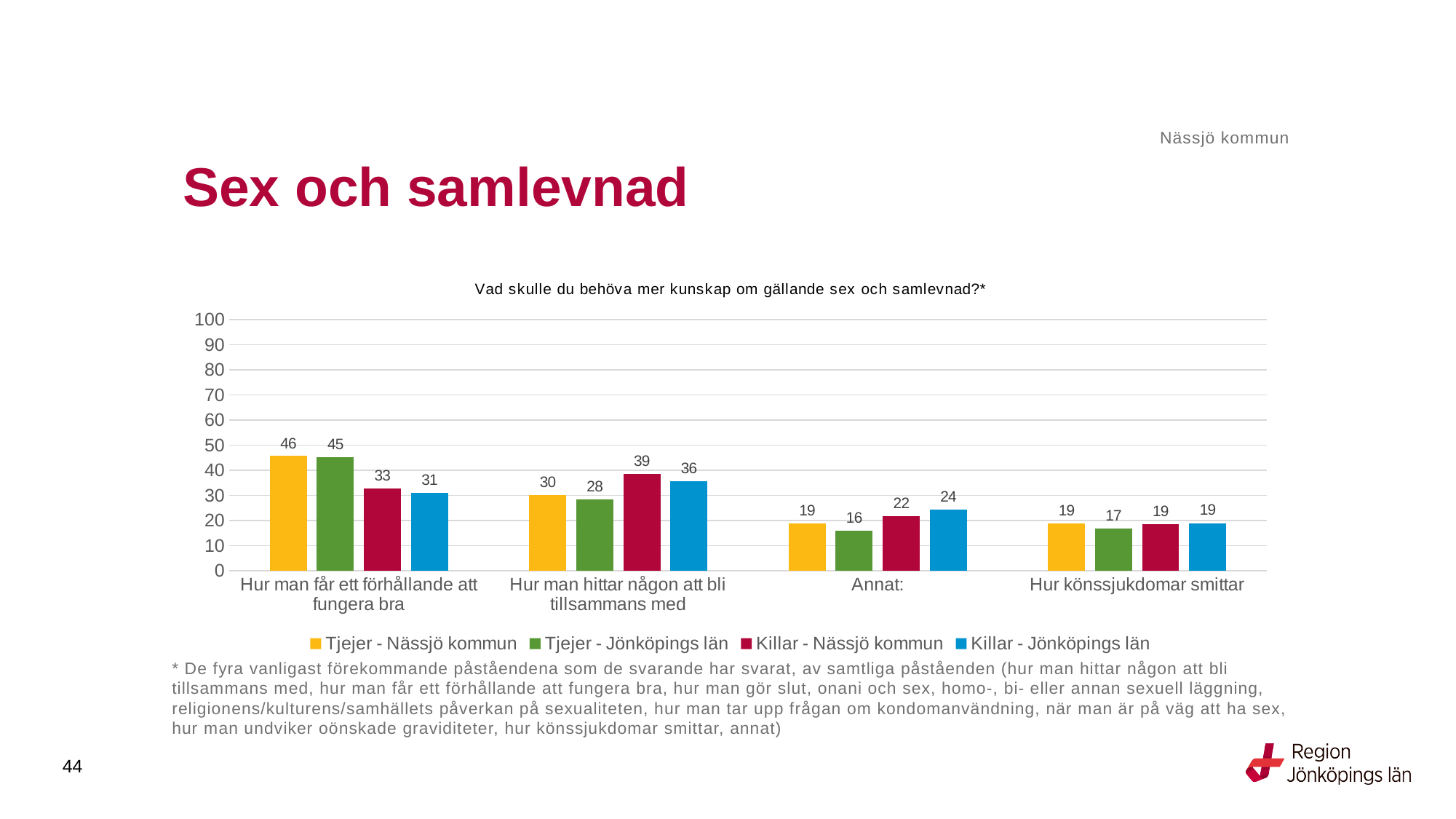
Which is larger for 'Hur man hittar någon att bli tillsammans med': Tjejer - Nässjö kommun or Killar - Nässjö kommun? Killar - Nässjö kommun How many categories are shown on the x axis? 4 What is the title of the chart? Vad skulle du behöva mer kunskap om gällande sex och samlevnad?* What is the value for Tjejer - Nässjö kommun for 'Hur man får ett förhållande att fungera bra'? 46 What is the difference between Tjejer - Nässjö kommun and Killar - Nässjö kommun for 'Hur man får ett förhållande att fungera bra'? 13 What is the value for Tjejer - Jönköpings län for 'Annat:'? 16 How many series does the legend list? 4 What kind of chart is shown on the slide? bar chart Which category has the highest value for Tjejer - Nässjö kommun? Hur man får ett förhållande att fungera bra What is the value for Killar - Jönköpings län for 'Hur man hittar någon att bli tillsammans med'? 36 Is the value for Killar - Jönköpings län for 'Annat:' greater or less than 30? less Which category has the lowest value for Killar - Nässjö kommun? Hur könssjukdomar smittar